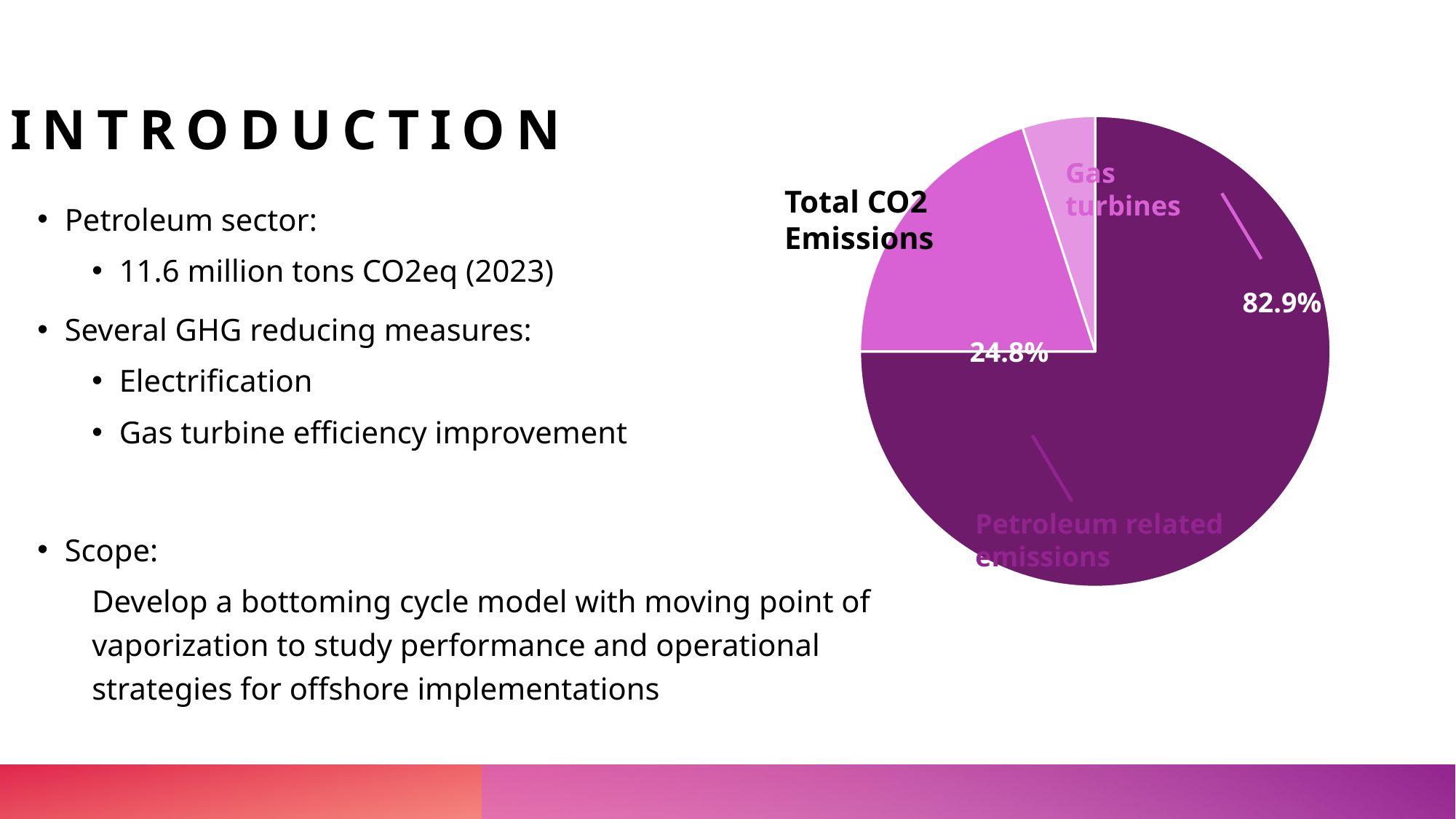
What is the title of the pie chart? Total CO2 Emissions What is the smaller of the two percentage labels shown on the pie chart? 24.8% What percentage is labelled on the Petroleum related emissions slice of the pie chart? 82.9% What kind of chart is shown on the slide? pie chart What colour is the Petroleum related emissions slice of the pie chart? dark purple How many slices does the pie chart have? 3 Which slice of the pie chart is the largest? Petroleum related emissions Which slice of the pie chart is the smallest? Gas turbines Which is larger on the pie chart: the slice labelled 82.9% or the slice labelled 24.8%? 82.9% Is the share of the Petroleum related emissions slice greater or less than 50%? greater